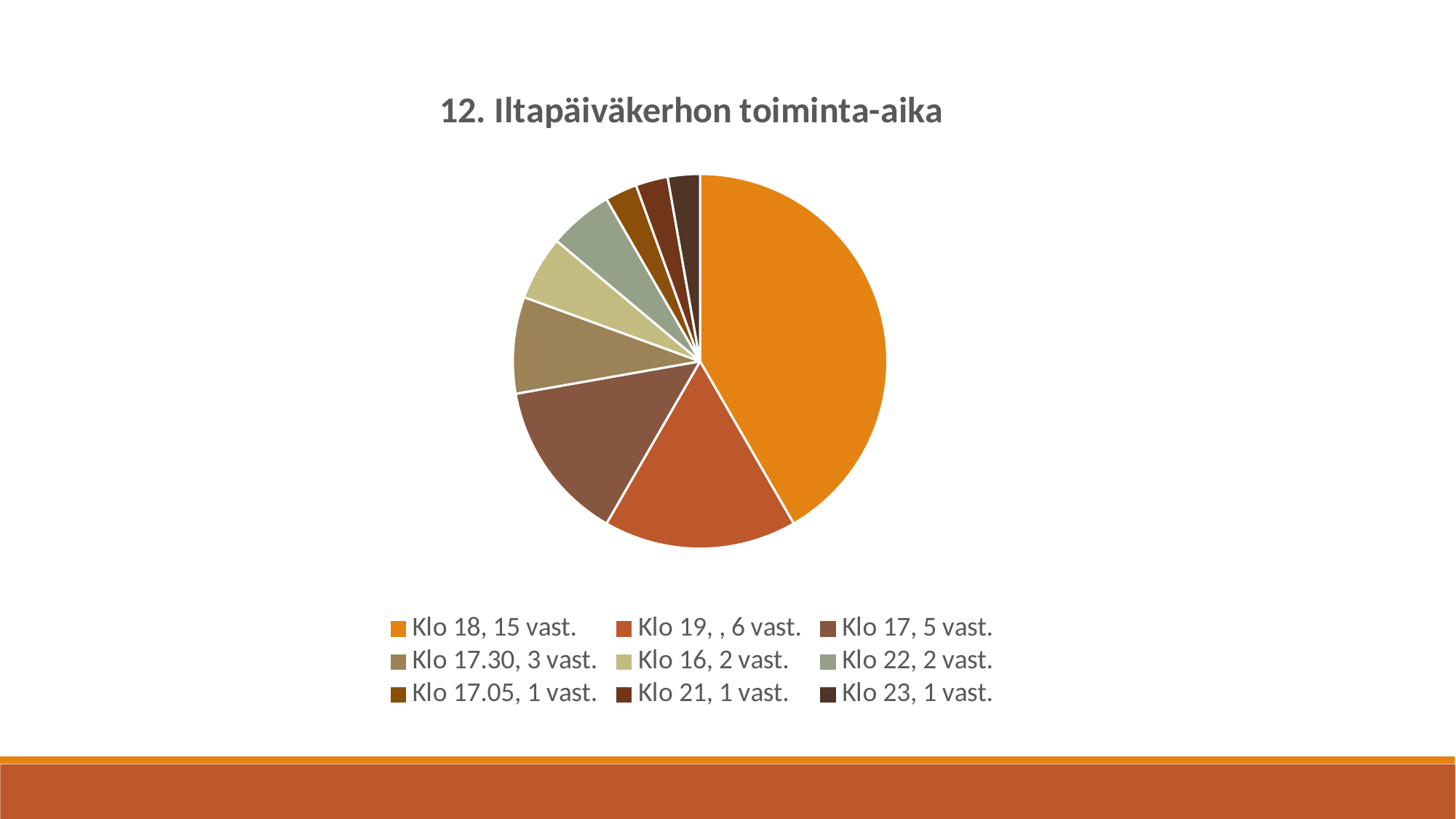
How many respondents chose Klo 18? 15 vast. How many respondents chose Klo 17.30? 3 vast. What is the difference in respondents between Klo 18 and Klo 19? 9 Which colour represents Klo 18 in the legend? orange What kind of chart is shown on the slide? pie chart How many respondents chose Klo 22? 2 vast. How many respondents chose Klo 19? 6 vast. What is the total number of respondents across all slices? 36 Which category has the largest slice of the pie? Klo 18 How many categories (slices) does the pie chart have? 9 What is the title of the chart? 12. Iltapäiväkerhon toiminta-aika Which has more respondents, Klo 17 or Klo 17.30? Klo 17